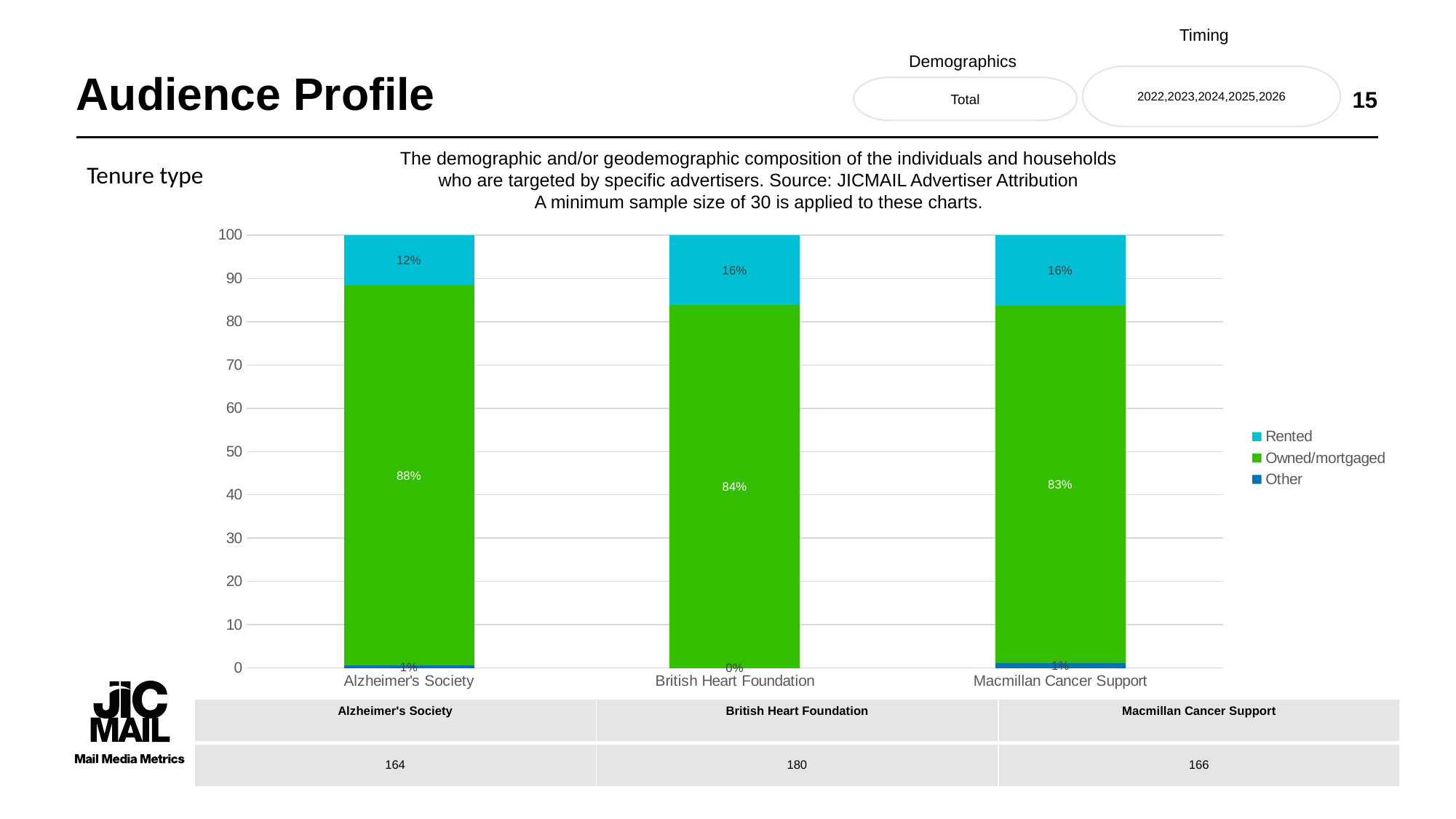
Which series is shown in green in the legend? Owned/mortgaged What is the Owned/mortgaged value for Macmillan Cancer Support? 83% What is the difference between the Owned/mortgaged values for Alzheimer's Society and British Heart Foundation? 4% Which category has the lowest Rented value? Alzheimer's Society Which is larger, the Rented value for Alzheimer's Society or the Rented value for Macmillan Cancer Support? Macmillan Cancer Support How many categories are shown on the x axis? 3 What is the Owned/mortgaged value for Alzheimer's Society? 88% How many series does the legend list? 3 What kind of chart is shown? Stacked bar chart Which category has the highest Owned/mortgaged value? Alzheimer's Society What is the Rented value for British Heart Foundation? 16% What is the Other value for Macmillan Cancer Support? 1%